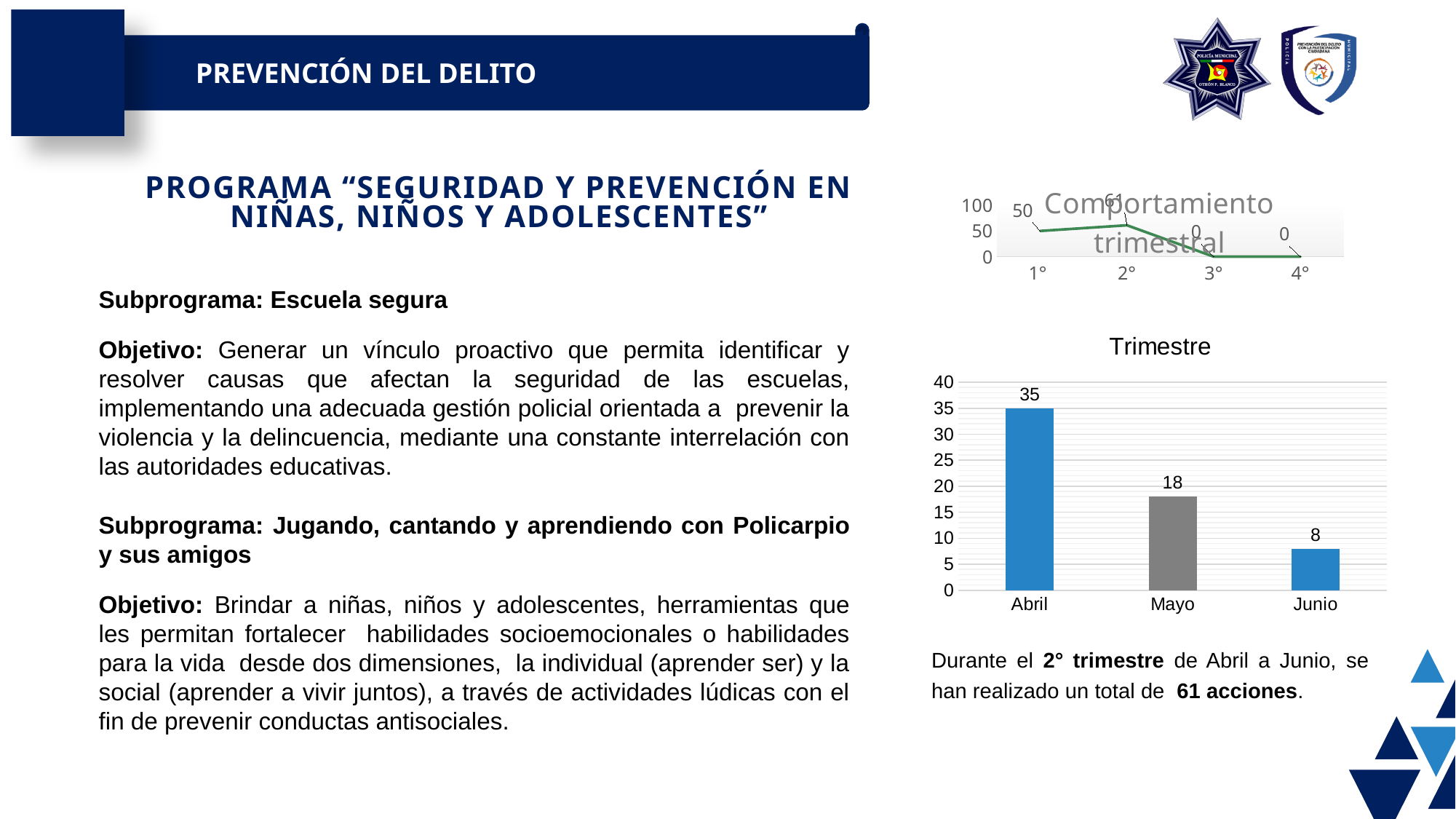
In the 'Trimestre' bar chart, what is the value for Abril? 35 In the 'Trimestre' bar chart, what is the total of the three months' values? 61 In the 'Trimestre' bar chart, which month has the lowest value? Junio In the 'Trimestre' bar chart, how many months are shown on the x axis? 3 In the 'Trimestre' bar chart, which is larger, the value for Mayo or the value for Junio? Mayo In the 'Trimestre' bar chart, which month has the highest value? Abril In the 'Trimestre' bar chart, do the values rise or fall from Abril to Junio? Fall In the 'Trimestre' bar chart, what is the difference between the values for Abril and Mayo? 17 In the 'Trimestre' bar chart, what is the value for Mayo? 18 What kind of chart is the 'Trimestre' chart? Bar chart In the 'Comportamiento trimestral' line chart, what is the value for 1°? 50 In the 'Trimestre' bar chart, what is the value for Junio? 8